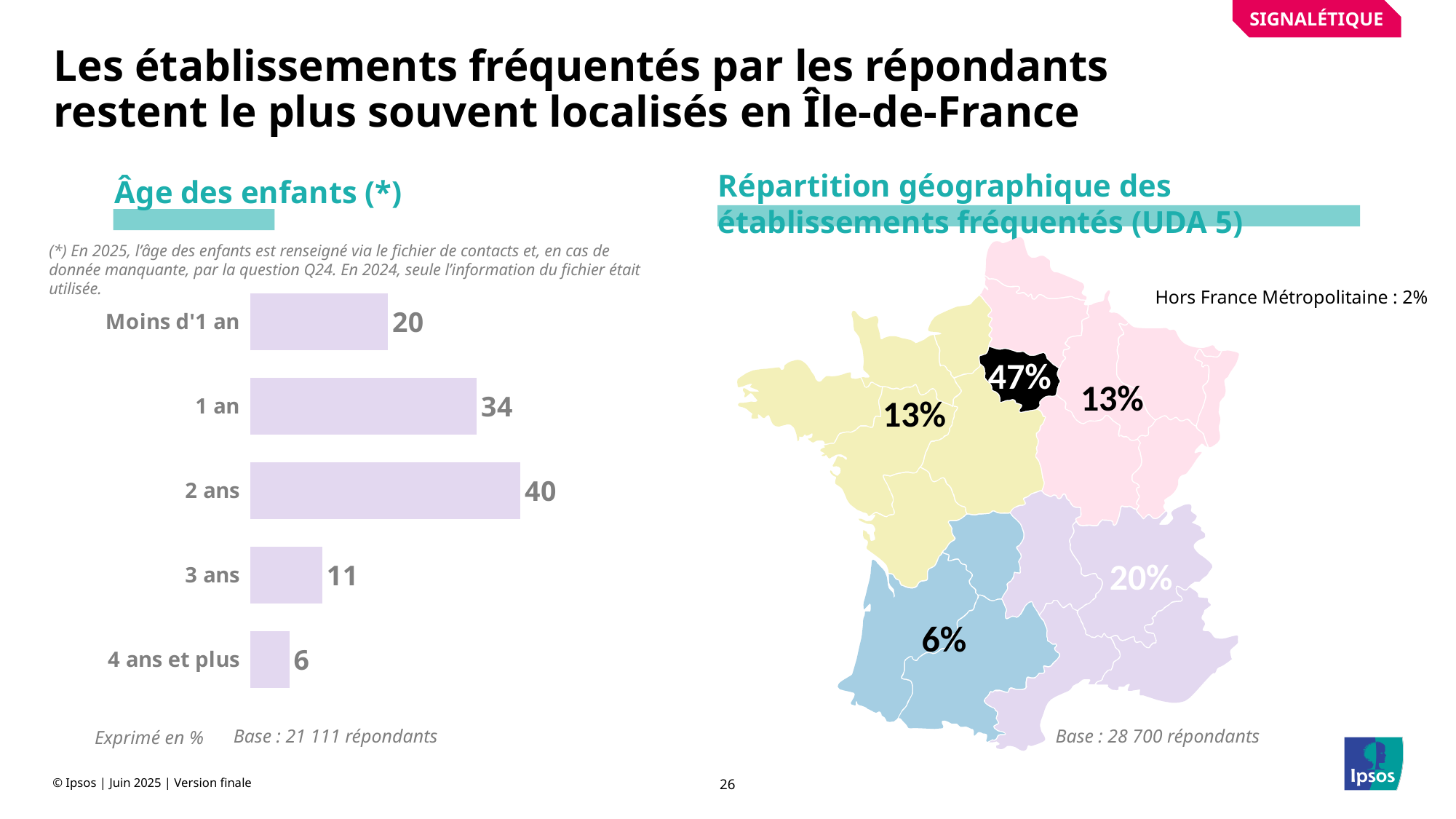
On the map 'Répartition géographique des établissements fréquentés (UDA 5)', what percentage is shown for the black-shaded region (Île-de-France)? 47% In the 'Âge des enfants (*)' chart, what is the difference between the values for '1 an' and '3 ans'? 23 What type of chart is the 'Âge des enfants (*)' chart? Bar chart In the 'Âge des enfants (*)' chart, what is the value for '4 ans et plus'? 6 In the 'Âge des enfants (*)' chart, which category has the highest value? 2 ans On the map 'Répartition géographique des établissements fréquentés (UDA 5)', what percentage is given for 'Hors France Métropolitaine'? 2% In the 'Âge des enfants (*)' chart, which is larger, the value for '1 an' or the value for 'Moins d'1 an'? 1 an How many categories are shown in the 'Âge des enfants (*)' chart? 5 In the 'Âge des enfants (*)' chart, what is the value for '2 ans'? 40 In the 'Âge des enfants (*)' chart, which category has the lowest value? 4 ans et plus In the 'Âge des enfants (*)' chart, what is the value for 'Moins d'1 an'? 20 In the 'Âge des enfants (*)' chart, what is the base of respondents stated below the chart? 21 111 répondants